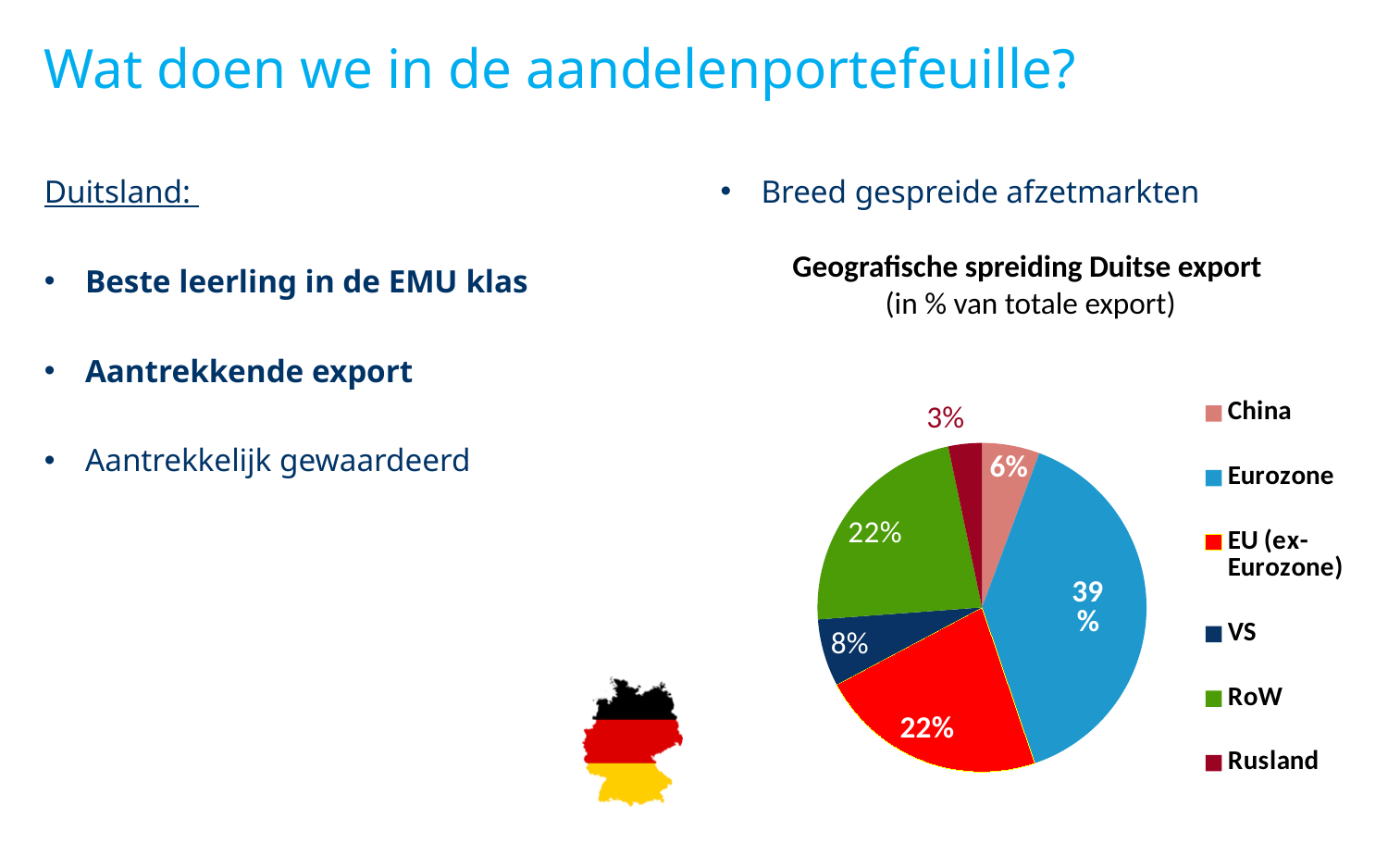
What is the difference between the Eurozone share and the RoW share? 17% What share of German exports goes to the Eurozone? 39% Which region has the largest share of German exports? Eurozone What share of German exports goes to China? 6% What kind of chart is shown on the slide? pie chart What share of German exports goes to EU (ex-Eurozone)? 22% Which is larger, the share for VS or the share for China? VS What share of German exports goes to VS? 8% What is the title of the chart? Geografische spreiding Duitse export Which region has the smallest share of German exports? Rusland What share of German exports goes to Rusland? 3% How many slices does the pie chart have? 6